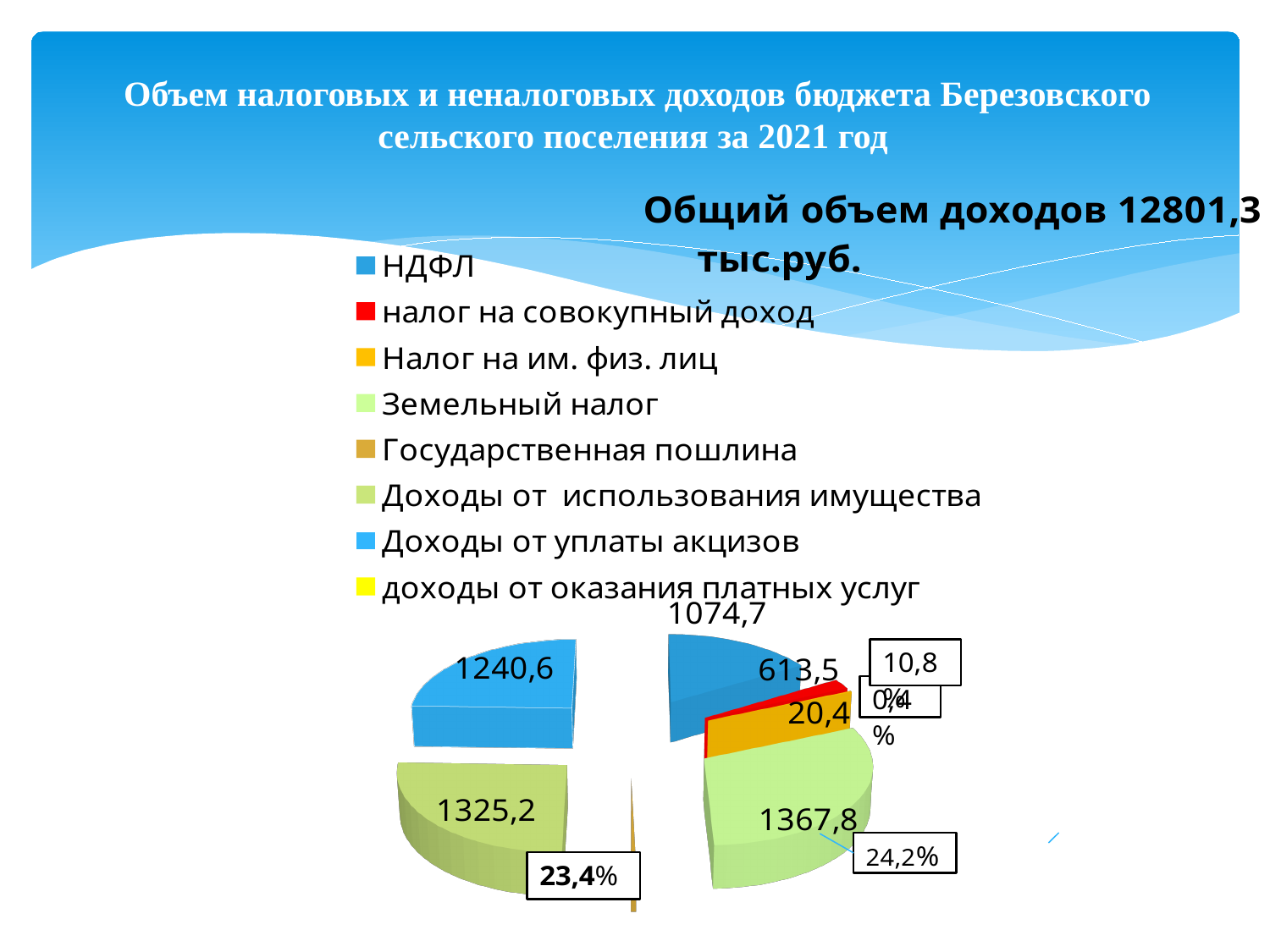
What is the difference between the values for Земельный налог and Налог на им. физ. лиц? 1347,4 What kind of chart is shown on the slide? pie chart What total revenue amount (Общий объем доходов) is stated on the slide? 12801,3 тыс.руб. How many entries does the chart legend list? 8 What is the difference between the values for Земельный налог and Доходы от использования имущества? 42,6 Which category has the largest labelled value in the pie chart? Земельный налог What is the value shown for налог на совокупный доход? 613,5 Which is larger: Земельный налог or Доходы от использования имущества? Земельный налог What is the value shown for Налог на им. физ. лиц? 20,4 What is the value shown for Земельный налог? 1367,8 What is the value shown for Доходы от использования имущества? 1325,2 What percentage label is attached to the Земельный налог slice? 24,2%